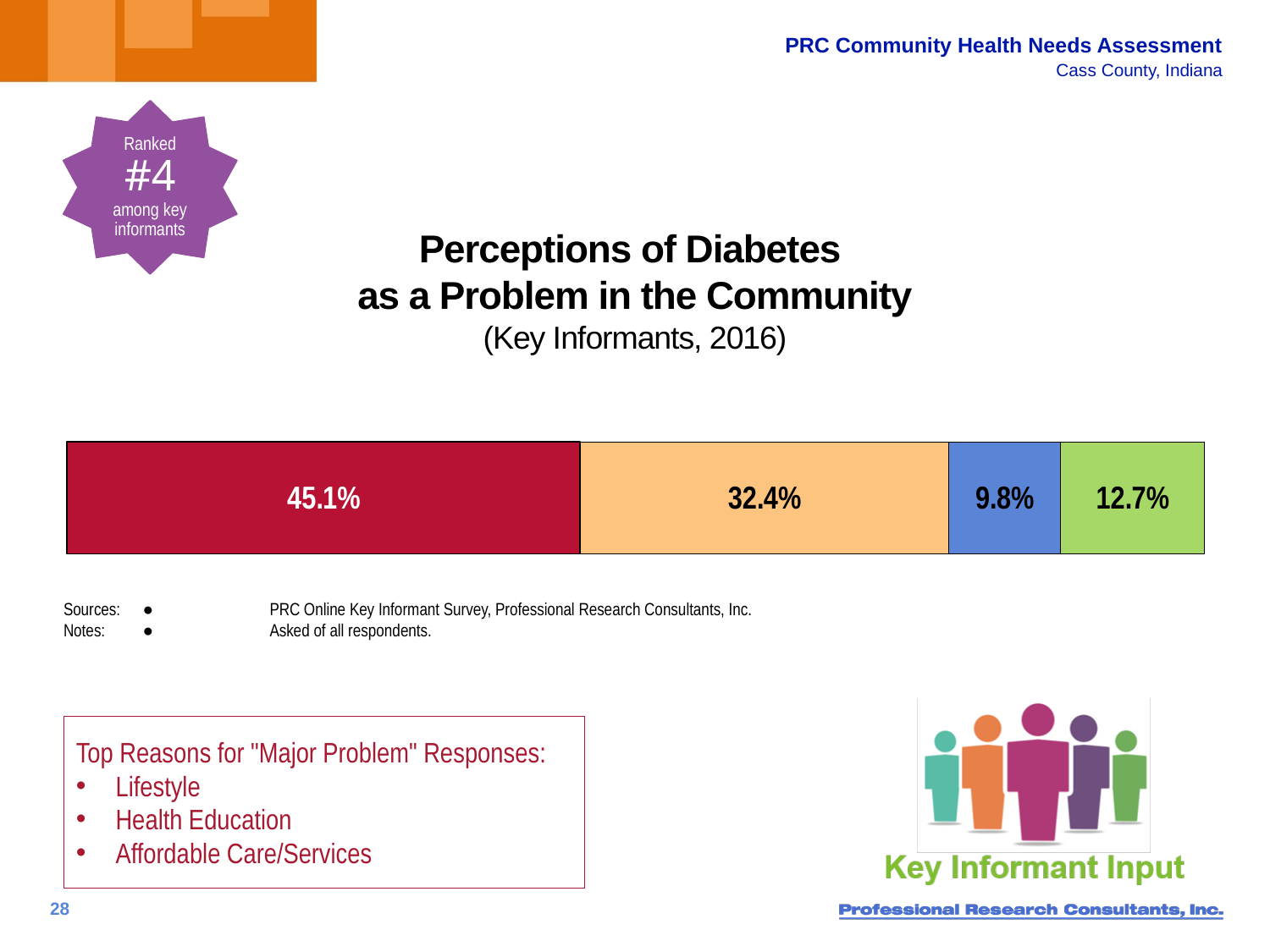
How many segments make up the stacked bar? 4 What is the difference between the red segment's value and the orange segment's value? 12.7 percentage points What is the value shown in the red segment of the bar? 45.1% What is the total of all four segments in the stacked bar? 100% Which segment of the bar has the smallest value? The blue segment (9.8%) What is the value shown in the orange segment of the bar? 32.4% Which segment of the bar has the largest value? The red segment (45.1%) What kind of chart is shown on the slide? A stacked bar chart What is the value shown in the blue segment of the bar? 9.8% What is the title of the chart? Perceptions of Diabetes as a Problem in the Community (Key Informants, 2016) Which is larger, the blue segment's value or the green segment's value? The green segment (12.7%) What is the value shown in the green segment at the right end of the bar? 12.7%